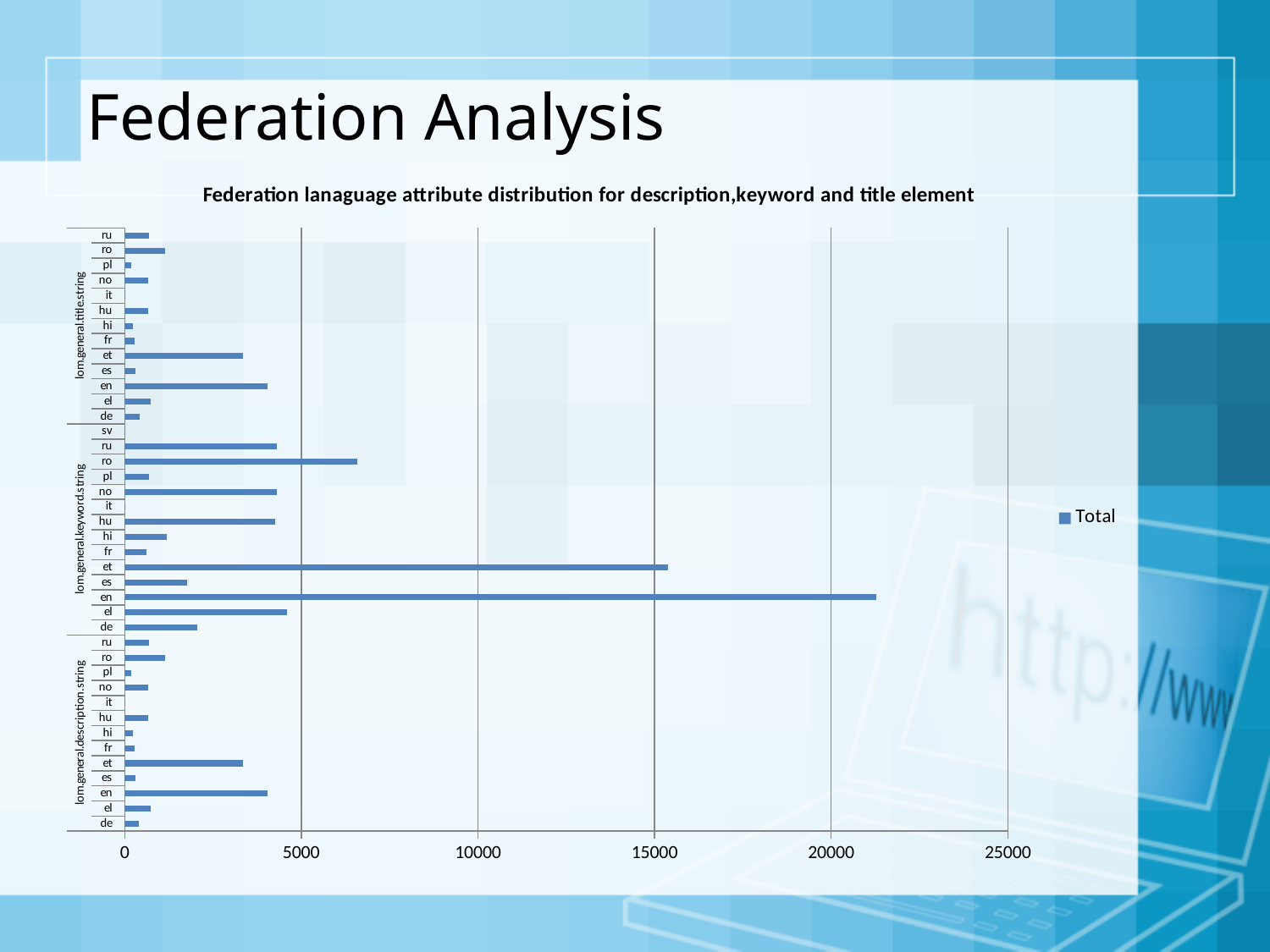
How many element groups (lom.general.*.string) are shown on the vertical axis? 3 What kind of chart is shown on the slide? Bar chart How many series does the legend list? 1 Which is larger in the lom.general.description.string group: the value for et or the value for pl? et What is the title of the chart? Federation lanaguage attribute distribution for description,keyword and title element Which is larger in the lom.general.keyword.string group: the value for en or the value for et? en What is the name of the series shown in the legend? Total Is the value for et in the lom.general.keyword.string group greater or less than 15000? greater Is the value for ro in the lom.general.keyword.string group greater or less than 5000? greater Is the value for en in the lom.general.keyword.string group greater or less than 20000? greater Which language in the lom.general.keyword.string group has the highest value? en